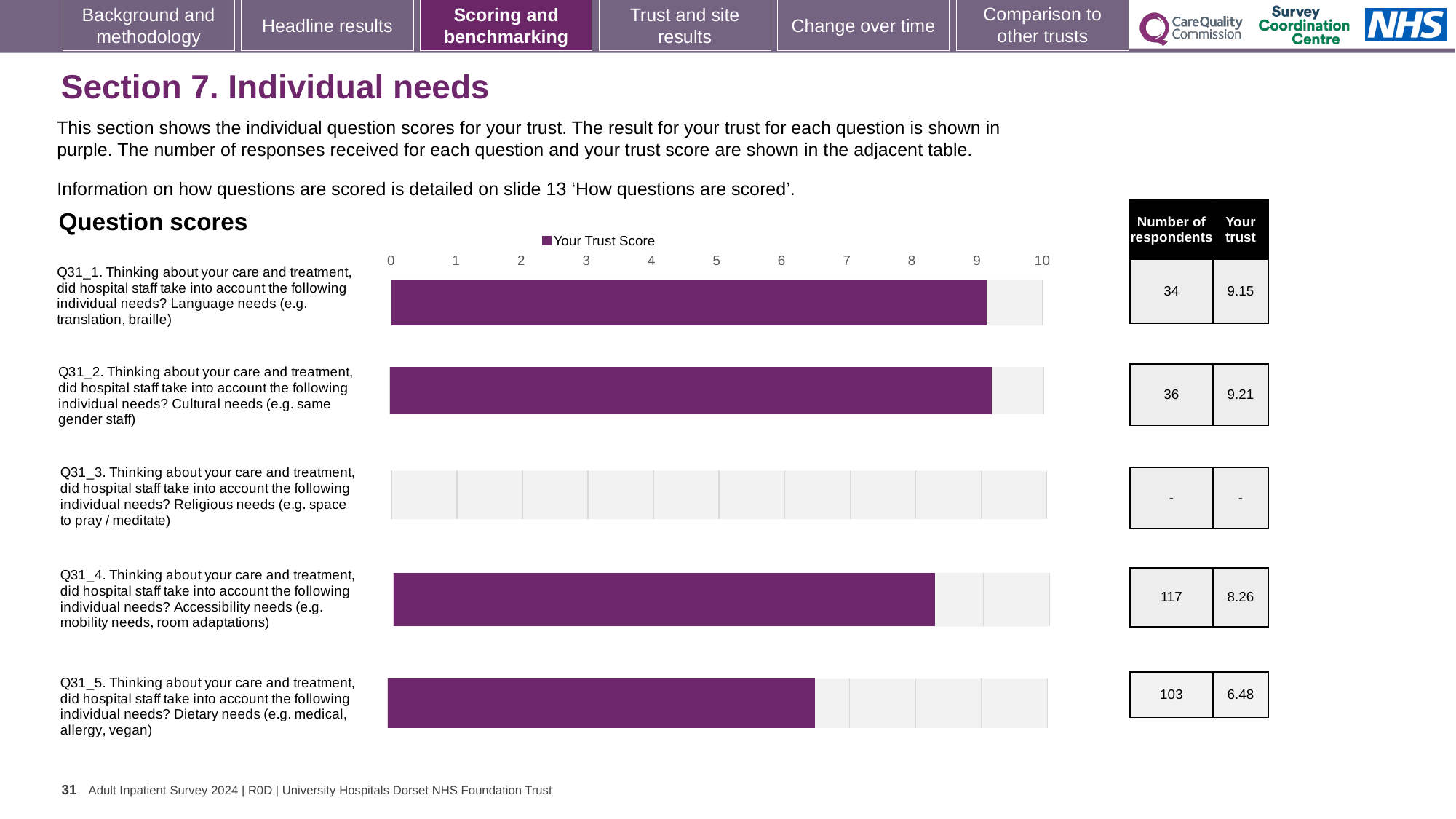
How many questions are listed in the chart? 5 What kind of chart is shown? Bar chart What is the trust score for Q31_4 (Accessibility needs)? 8.26 Which question has the highest trust score? Q31_2 (Cultural needs) What is the trust score for Q31_2 (Cultural needs)? 9.21 Is the trust score for Q31_5 (Dietary needs) greater or less than 7? less How many series does the legend list? 1 Which has a larger trust score, Q31_4 (Accessibility needs) or Q31_5 (Dietary needs)? Q31_4 (Accessibility needs) Among the questions with a plotted score, which has the lowest trust score? Q31_5 (Dietary needs) What is the name of the series shown in the legend? Your Trust Score What is the trust score for Q31_5 (Dietary needs)? 6.48 What is the difference between the trust scores for Q31_1 (Language needs) and Q31_5 (Dietary needs)? 2.67